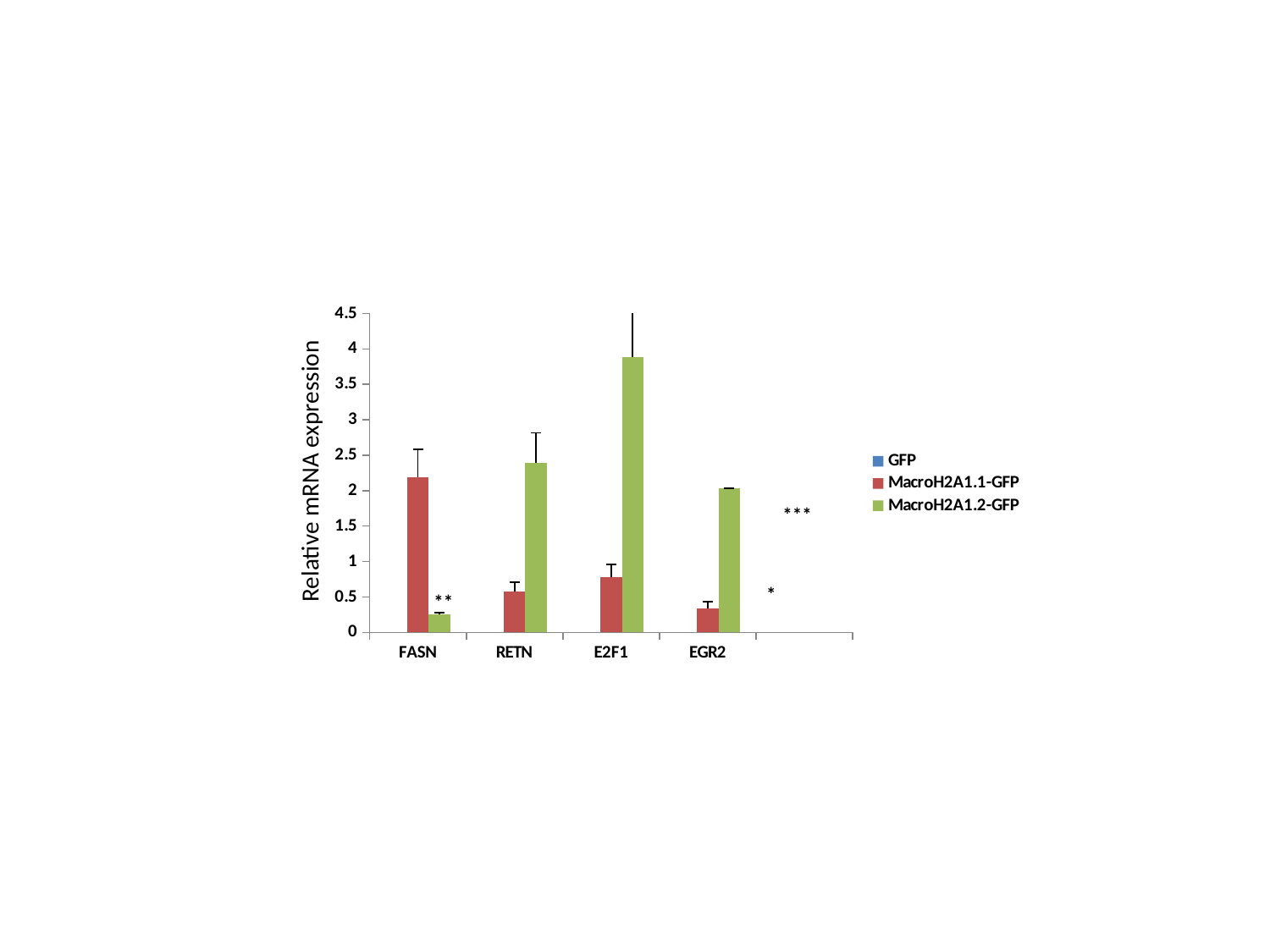
Which colour represents the MacroH2A1.2-GFP series in the legend? green For FASN, which series has the larger bar, MacroH2A1.1-GFP or MacroH2A1.2-GFP? MacroH2A1.1-GFP Which gene has the lowest MacroH2A1.2-GFP bar? FASN For E2F1, which series has the larger bar, MacroH2A1.1-GFP or MacroH2A1.2-GFP? MacroH2A1.2-GFP How many series does the legend list? 3 What is the label on the y axis? Relative mRNA expression Is the MacroH2A1.1-GFP value for EGR2 greater or less than 0.5? less Which gene has the highest MacroH2A1.2-GFP bar? E2F1 How many labelled gene categories are shown on the x axis? 4 What kind of chart is shown on the slide? bar chart Which gene has the highest MacroH2A1.1-GFP bar? FASN Is the MacroH2A1.2-GFP value for E2F1 greater or less than 3.5? greater